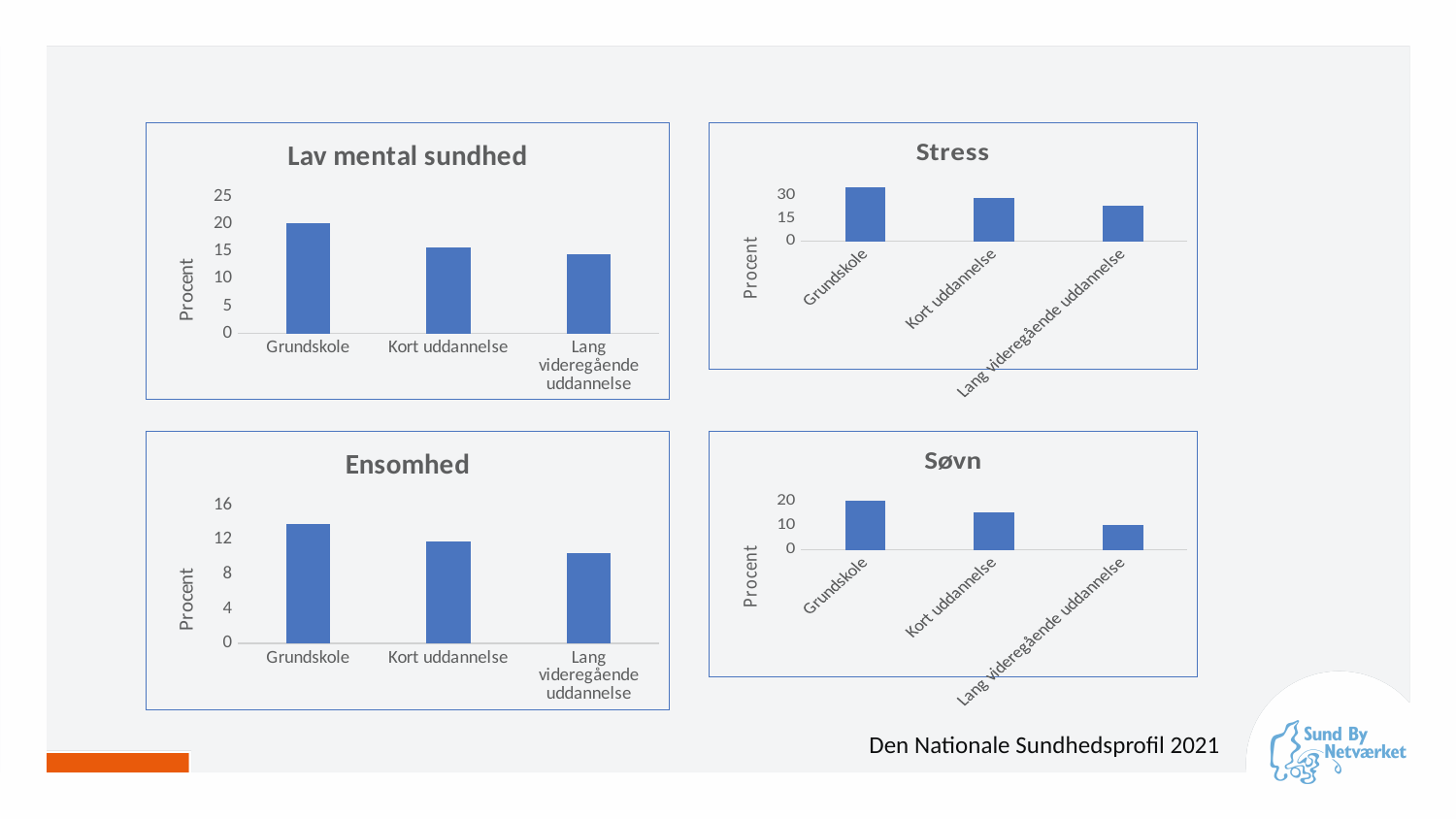
In the 'Lav mental sundhed' chart, which category has the highest value? Grundskole In the 'Stress' chart, which category has the lowest value? Lang videregående uddannelse In the 'Søvn' chart, do the values rise or fall from Grundskole to Lang videregående uddannelse? fall What kind of chart is the 'Stress' chart? bar chart In the 'Lav mental sundhed' chart, is the value for Grundskole greater or less than 15? greater In the 'Søvn' chart, which is larger, the value for Grundskole or the value for Kort uddannelse? Grundskole What is the title of the chart in the top-right position of the slide? Stress In the 'Stress' chart, is the value for Grundskole greater or less than 30? greater How many categories are shown in the 'Ensomhed' chart? 3 What is the y-axis label on the 'Ensomhed' chart? Procent In the 'Ensomhed' chart, is the value for Grundskole greater or less than 12? greater